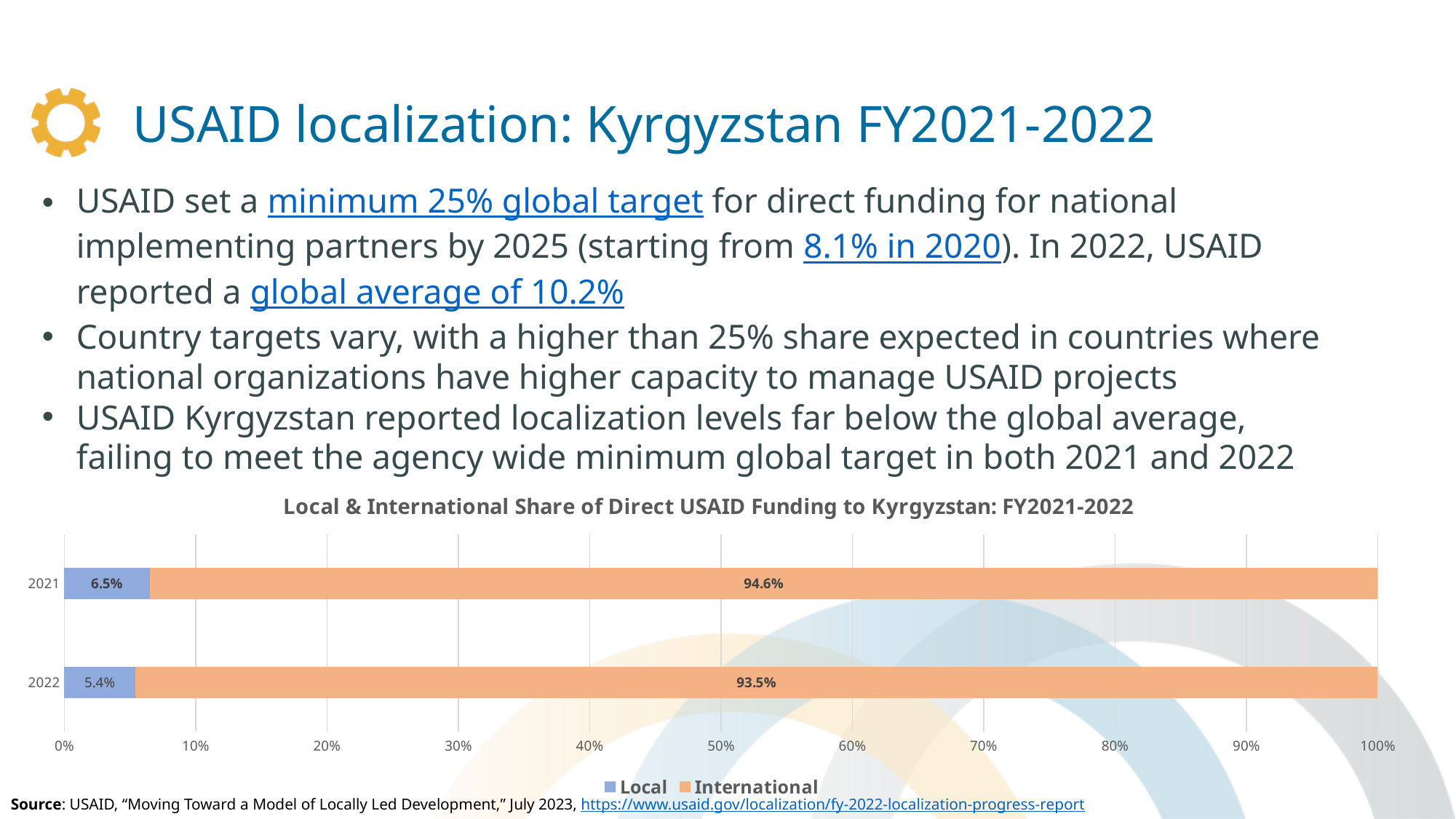
By how many percentage points did the Local share fall from 2021 to 2022? 1.1 percentage points What is the International share of direct USAID funding to Kyrgyzstan in 2021? 94.6% Which colour represents the International series in the chart? Orange How many years are shown in the chart? 2 Which is larger: the Local share in 2021 or the Local share in 2022? Local share in 2021 What kind of chart is shown on the slide? Stacked horizontal bar chart In which year was the Local share of direct USAID funding to Kyrgyzstan higher? 2021 What is the Local share of direct USAID funding to Kyrgyzstan in 2022? 5.4% How many series does the chart legend list? 2 What is the International share of direct USAID funding to Kyrgyzstan in 2022? 93.5% What is the Local share of direct USAID funding to Kyrgyzstan in 2021? 6.5%